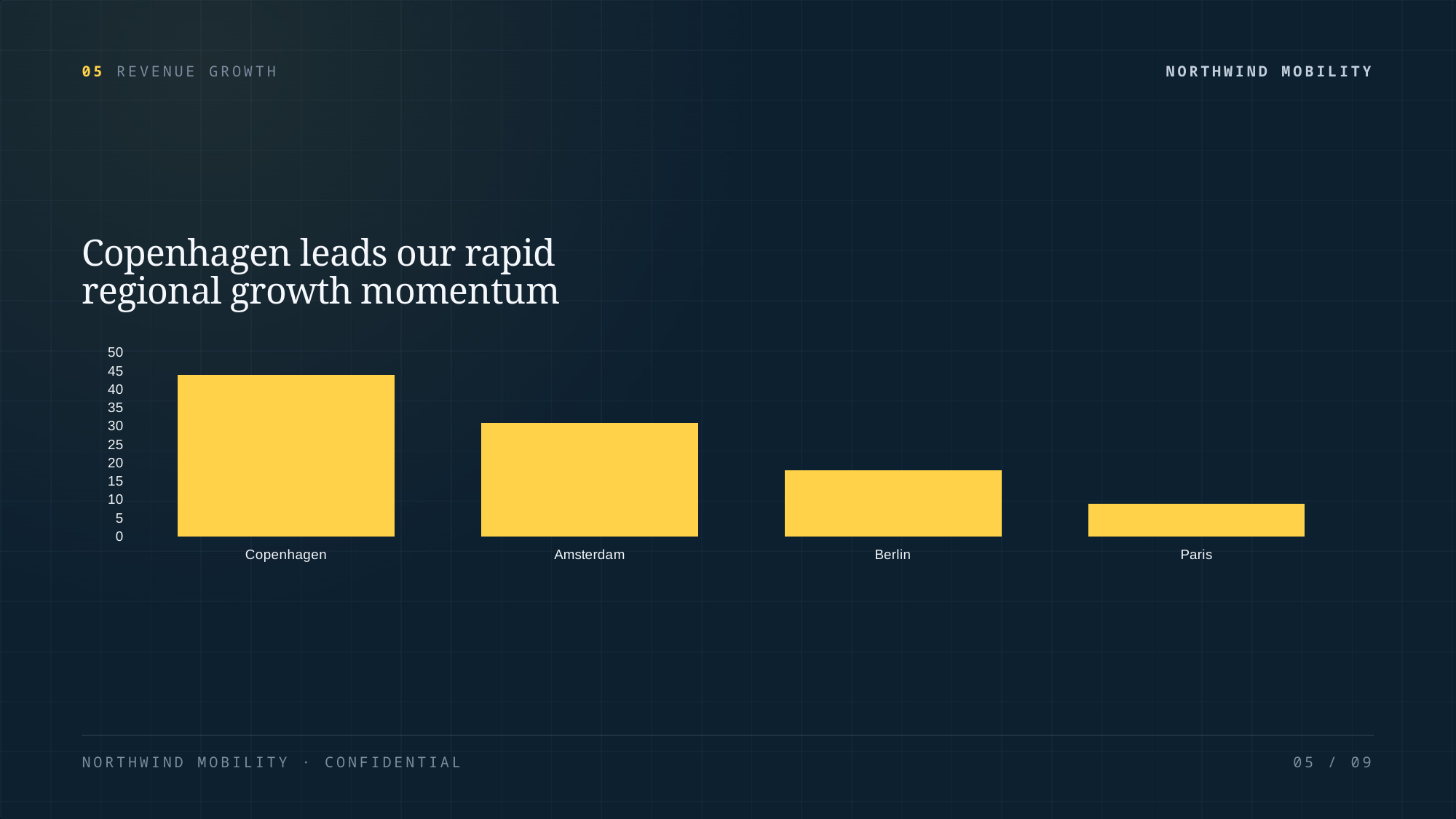
Is the value for Paris greater or less than 15? less What is the title of the slide containing the chart? Copenhagen leads our rapid regional growth momentum Which is larger, the value for Amsterdam or the value for Berlin? Amsterdam Which city has the lowest bar? Paris Is the value for Amsterdam greater or less than 35? less What is the highest value shown on the vertical axis? 50 What kind of chart is shown on the slide? bar chart How many cities are shown on the chart? 4 Do the values rise or fall moving from Copenhagen to Paris along the x axis? fall Which city has the highest bar? Copenhagen Is the value for Berlin greater or less than 20? less